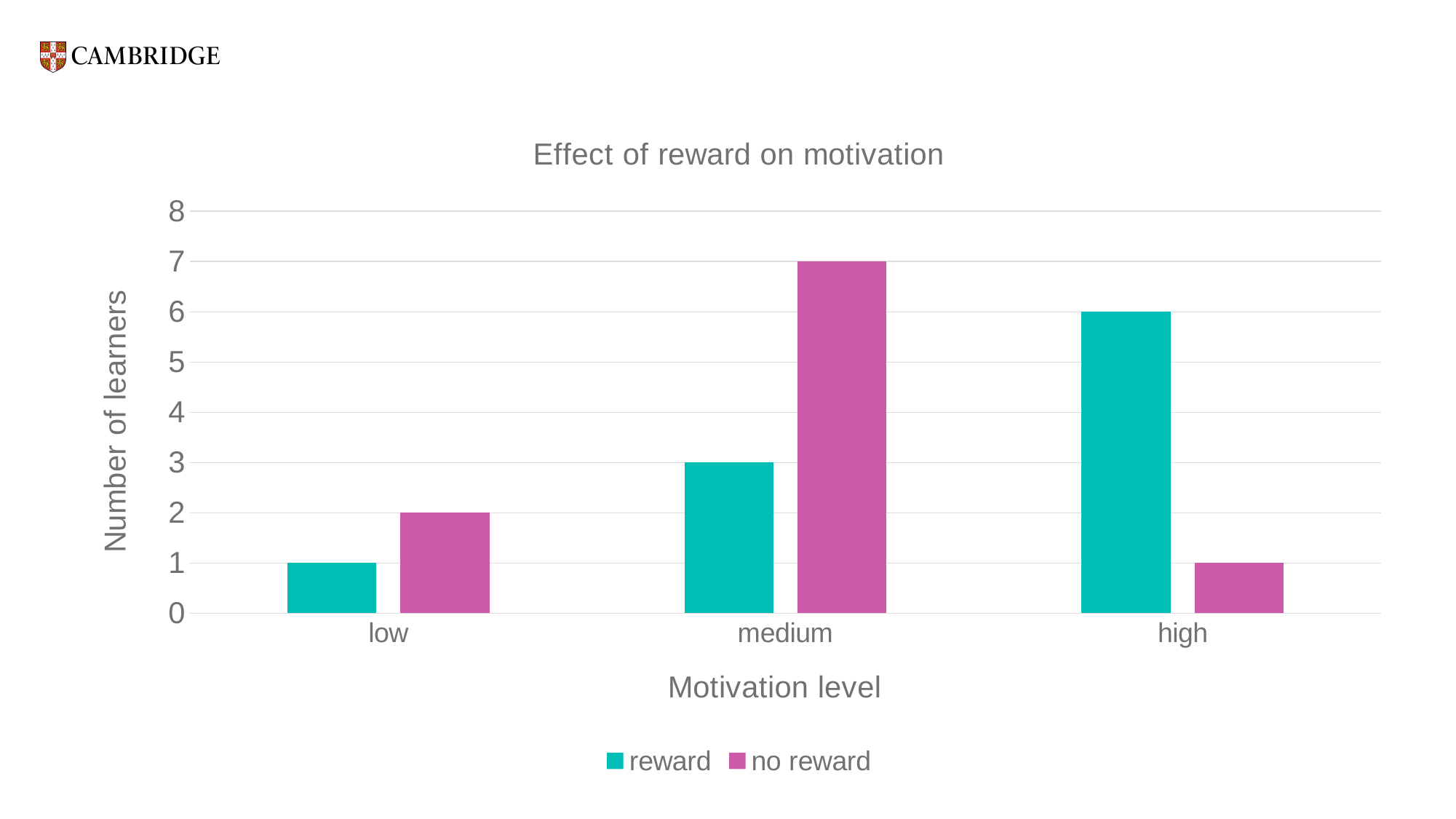
Is the value for 'no reward' at 'medium' greater or less than 5? greater What is the number of learners for 'reward' at the 'low' motivation level? 1 How many series does the legend list? 2 What is the title of the chart? Effect of reward on motivation What is the difference between 'no reward' and 'reward' at the 'medium' motivation level? 4 How many motivation levels are shown on the x axis? 3 Which motivation level has the highest number of learners in the 'no reward' series? medium What is the number of learners for 'reward' at the 'high' motivation level? 6 What is the number of learners for 'no reward' at the 'medium' motivation level? 7 At the 'high' motivation level, which series has more learners, 'reward' or 'no reward'? reward What kind of chart is shown on the slide? bar chart Which motivation level has the lowest number of learners in the 'reward' series? low